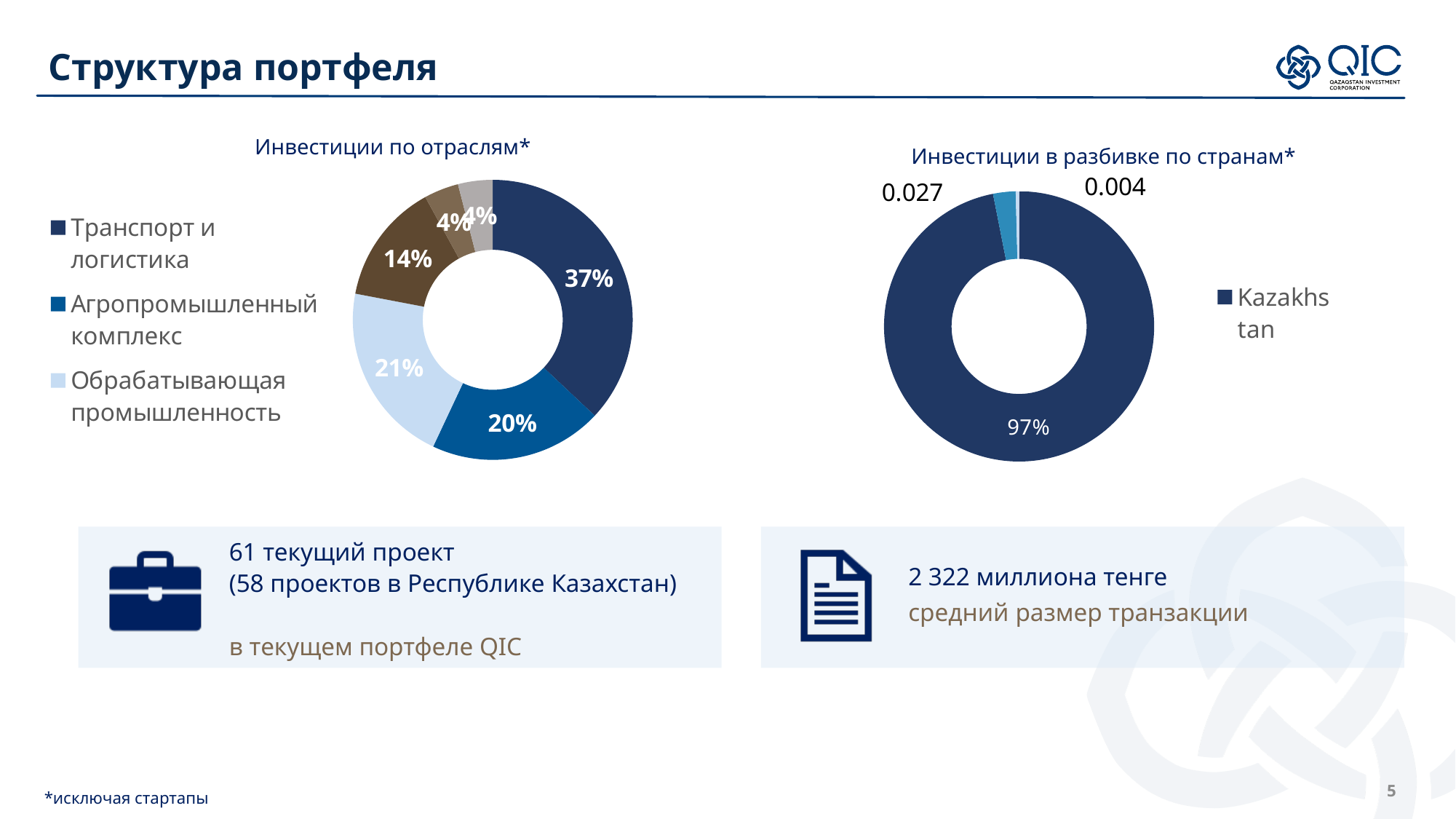
In the chart titled "Инвестиции по отраслям*", what share is shown for Обрабатывающая промышленность? 21% In the chart titled "Инвестиции по отраслям*", how many slices does the donut have? 6 In the chart titled "Инвестиции в разбивке по странам*", which country is named in the legend? Kazakhstan In the chart titled "Инвестиции по отраслям*", what is the difference in percentage points between Транспорт и логистика and Агропромышленный комплекс? 17 percentage points In the chart titled "Инвестиции по отраслям*", which sector has the largest share? Транспорт и логистика In the chart titled "Инвестиции по отраслям*", what share is shown for Агропромышленный комплекс? 20% In the chart titled "Инвестиции по отраслям*", what share is shown for Транспорт и логистика? 37% In the chart titled "Инвестиции в разбивке по странам*", what share is shown for Kazakhstan? 97% In the chart titled "Инвестиции в разбивке по странам*", how many slices does the donut have? 3 In the chart titled "Инвестиции по отраслям*", which is larger: Обрабатывающая промышленность or Агропромышленный комплекс? Обрабатывающая промышленность What kind of chart is "Инвестиции по отраслям*"? Donut (pie) chart In the chart titled "Инвестиции по отраслям*", how many entries does the legend list? 3